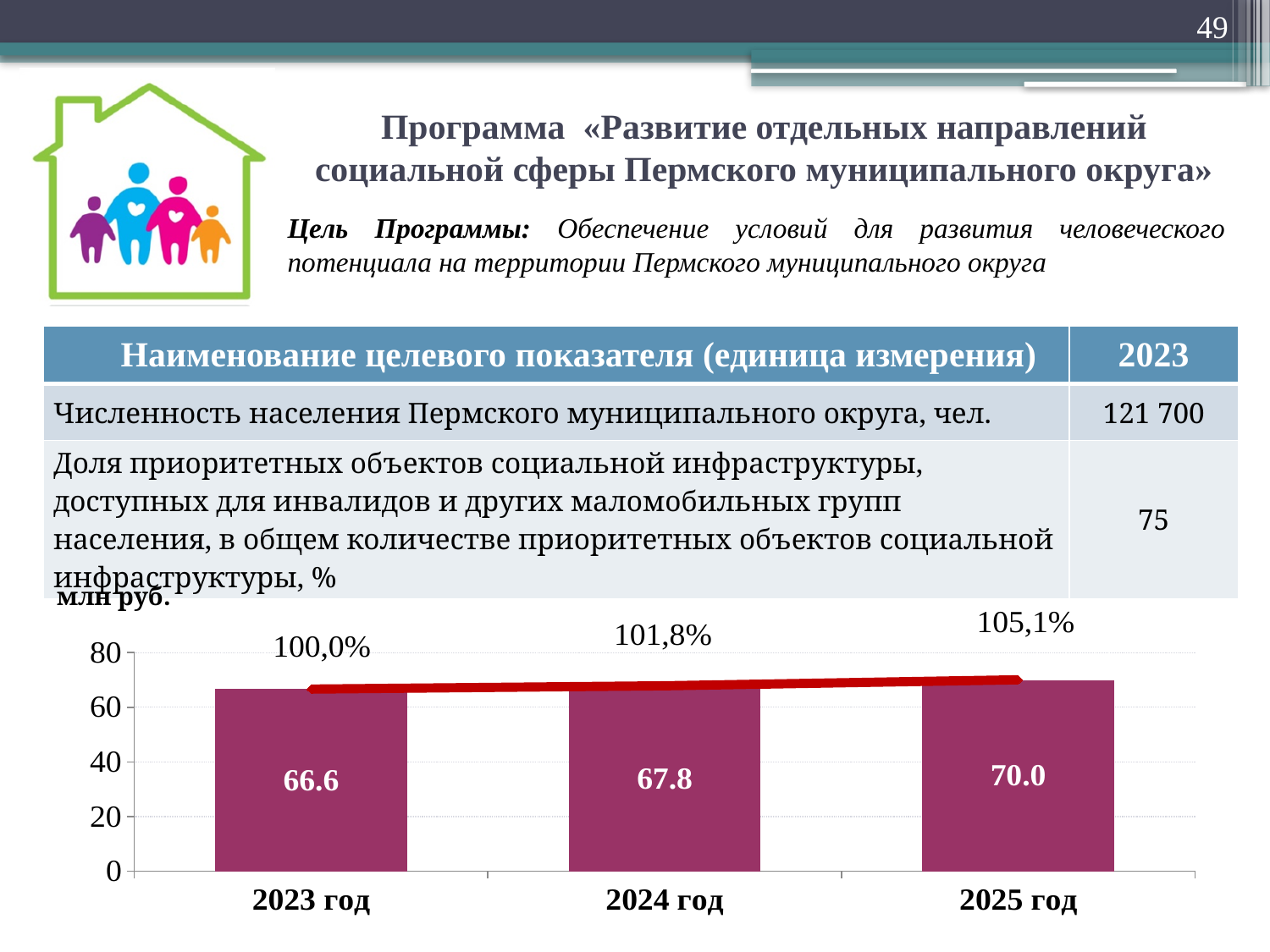
What is the value for 2023 год in the bar chart? 66.6 How many bars are shown in the chart? 3 Which is larger, the value for 2024 год or the value for 2023 год? 2024 год What percentage label is shown above the 2025 год bar? 105,1% Which year has the lowest bar in the chart? 2023 год Is the value for 2025 год greater or less than 60? greater What is the value for 2025 год in the bar chart? 70.0 What kind of chart is shown on the slide? bar chart What is the value for 2024 год in the bar chart? 67.8 Do the bar values rise or fall from 2023 год to 2025 год? rise What is the difference between the values for 2025 год and 2023 год? 3.4 Which year has the highest bar in the chart? 2025 год